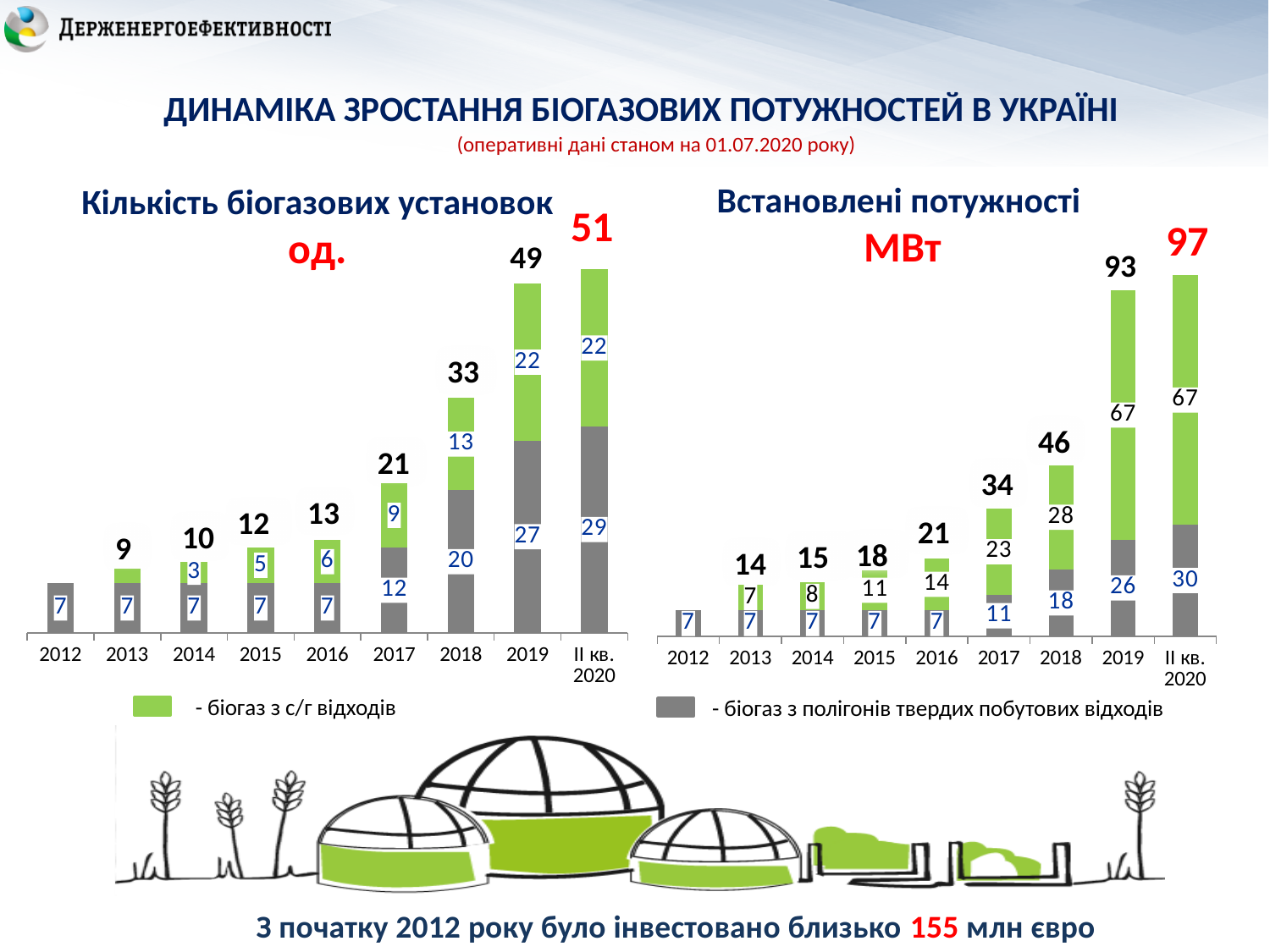
How many categories are shown on the x axis of the chart 'Кількість біогазових установок'? 9 In the chart 'Встановлені потужності', do the total values rise or fall from 2012 to II кв. 2020? Rise How many series does the legend list for the charts on this slide? 2 In the chart 'Кількість біогазових установок', what is the value of the grey segment (біогаз з полігонів твердих побутових відходів) in 2018? 20 In the chart 'Кількість біогазових установок', what is the total number of biogas installations in 2019? 49 In the chart 'Встановлені потужності', what is the difference between the total for 2019 and the total for 2018? 47 In the chart 'Встановлені потужності', what is the value of the green segment (біогаз з с/г відходів) in 2017? 23 In the chart 'Кількість біогазових установок', which category has the lowest total? 2012 In the chart 'Встановлені потужності', which year has the highest total installed capacity? II кв. 2020 What type of chart is 'Встановлені потужності'? Stacked bar chart In the chart 'Кількість біогазових установок', which is larger: the green segment in 2017 or the green segment in 2018? 2018 In the chart 'Встановлені потужності', what is the total installed capacity for II кв. 2020? 97